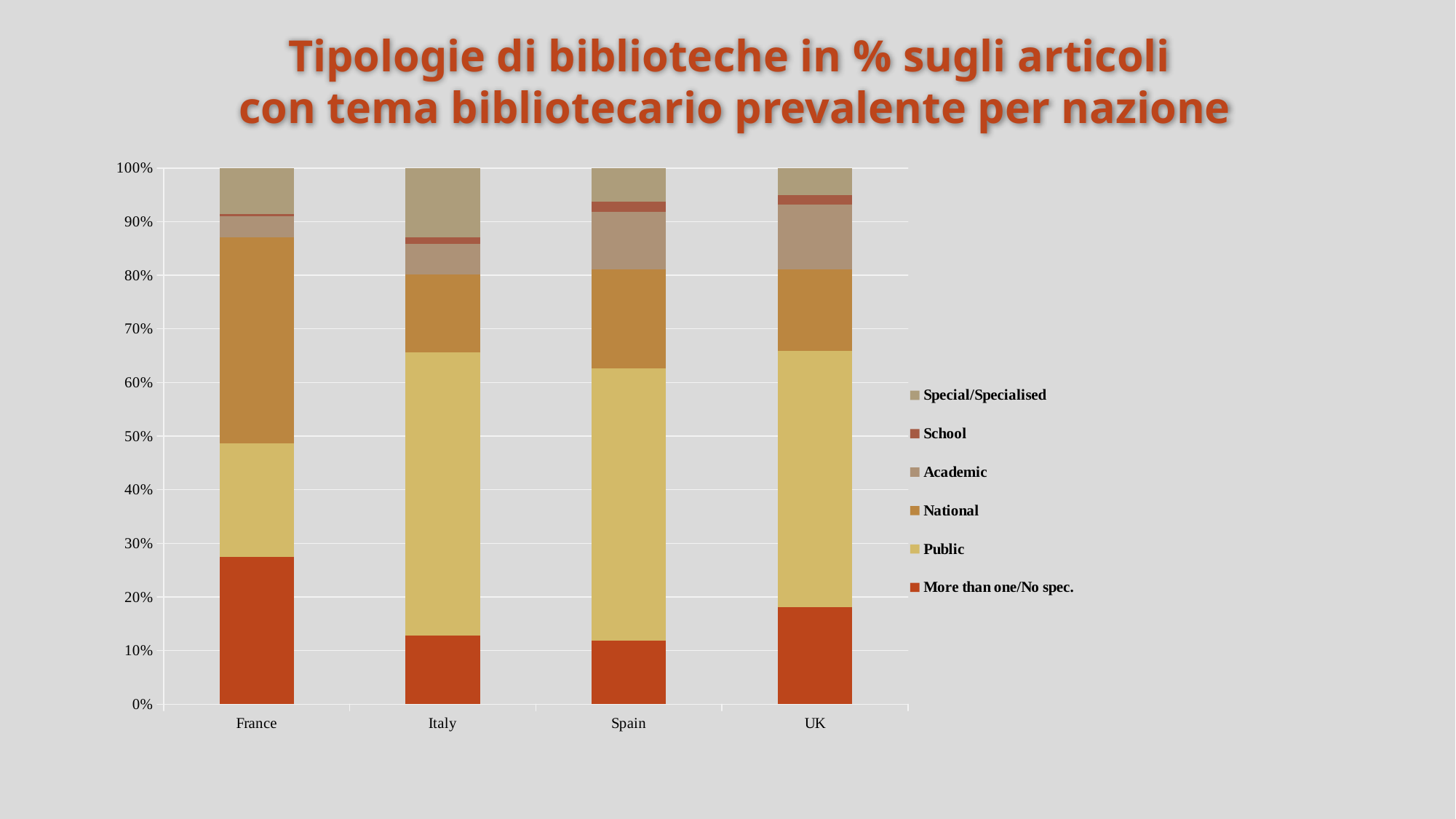
Is the 'More than one/No spec.' segment larger for France or for UK? France Which country has the largest 'More than one/No spec.' segment? France What kind of chart is shown on the slide? Stacked bar chart Is the 'National' value for France greater or less than 30%? greater Is the 'National' segment larger for France or for Italy? France How many series does the chart's legend list? 6 How many countries are shown on the x axis of the chart? 4 What does each stacked bar total on the y axis? 100% Which country has the largest 'National' segment? France Which series is listed at the bottom of the legend? More than one/No spec. Which country has the largest 'Special/Specialised' segment? Italy Is the 'More than one/No spec.' value for France greater or less than 20%? greater